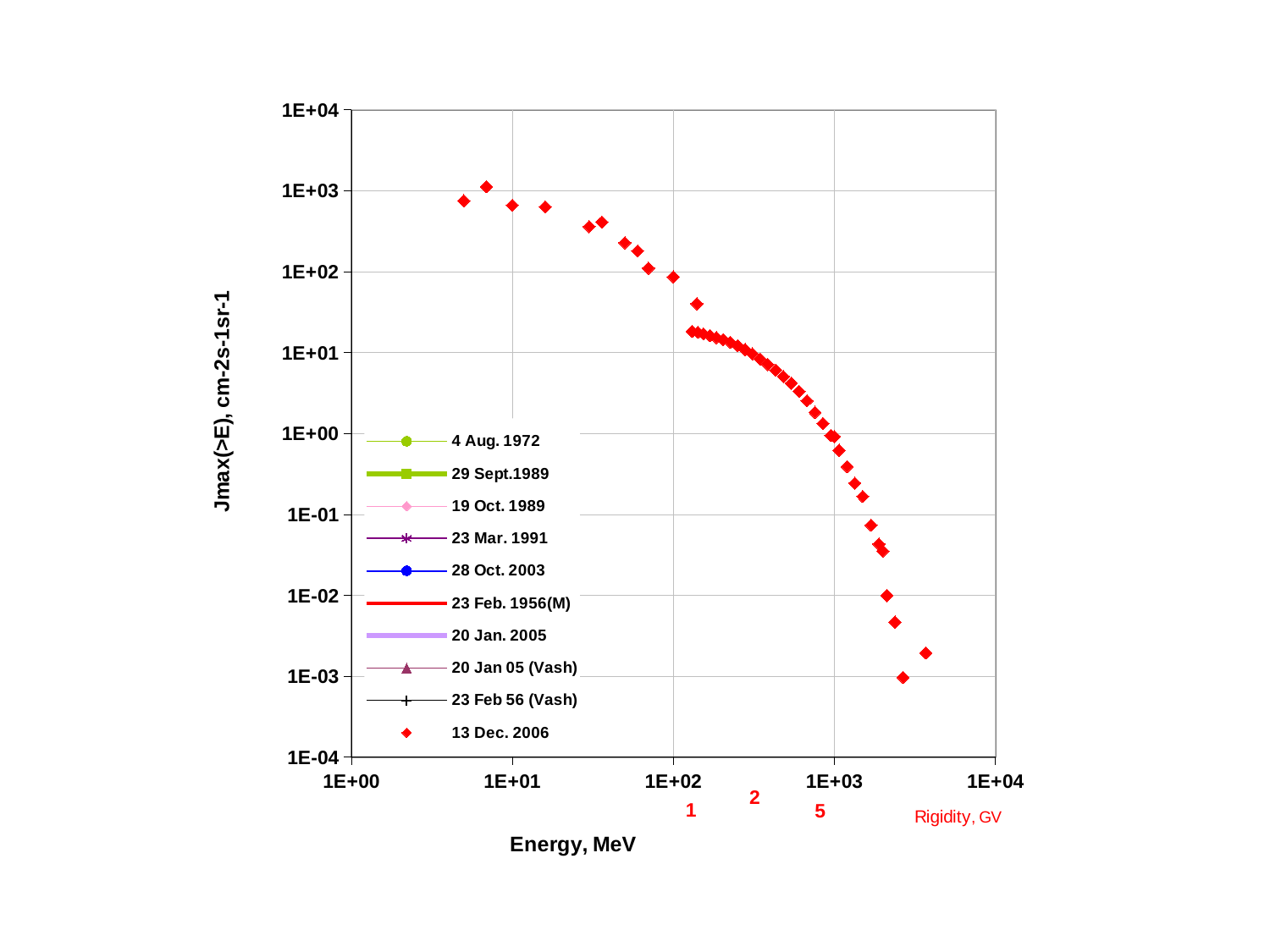
Is the value for 13 Dec. 2006 at an energy of 1E+03 MeV greater or less than 1E+01? less Do the plotted values for 13 Dec. 2006 rise or fall as energy increases along the x axis? fall What is the label of the x axis? Energy, MeV What is the label of the y axis? Jmax(>E), cm-2s-1sr-1 Is the value for 13 Dec. 2006 at an energy of 1E+01 MeV greater or less than 1E+03? less Is the lowest plotted value for 13 Dec. 2006 greater or less than 1E-02? less Which is larger for 13 Dec. 2006: the value at an energy of 1E+01 MeV or the value at an energy of 1E+03 MeV? the value at 1E+01 MeV Which legend entry corresponds to the red diamond markers plotted on the chart? 13 Dec. 2006 What kind of chart is shown on the slide? scatter chart How many series does the legend list? 10